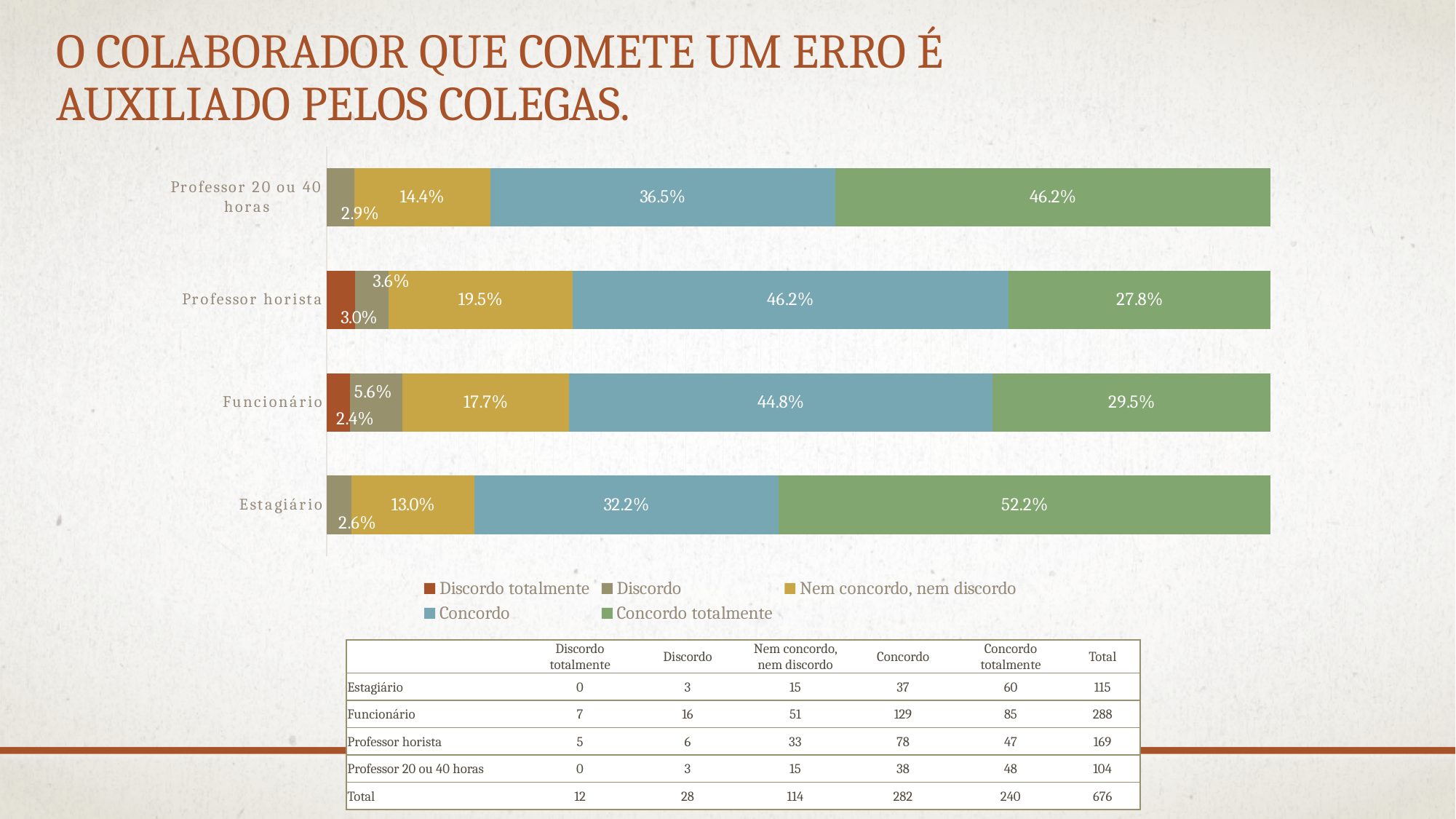
How many series does the chart legend list? 5 What is the "Concordo totalmente" value for Estagiário? 52.2% Which category has the highest "Concordo totalmente" value? Estagiário What kind of chart is shown on the slide? Stacked bar chart What is the "Nem concordo, nem discordo" value for Funcionário? 17.7% Which legend entry is shown in green? Concordo totalmente What is the difference between the "Concordo totalmente" values for Professor 20 ou 40 horas and Professor horista? 18.4% Which category has the lowest "Concordo" value? Estagiário Which is larger: the "Concordo" value for Funcionário or for Professor 20 ou 40 horas? Funcionário What is the "Discordo" value for Professor 20 ou 40 horas? 2.9% How many categories are plotted on the chart? 4 What is the "Concordo" value for Professor horista? 46.2%